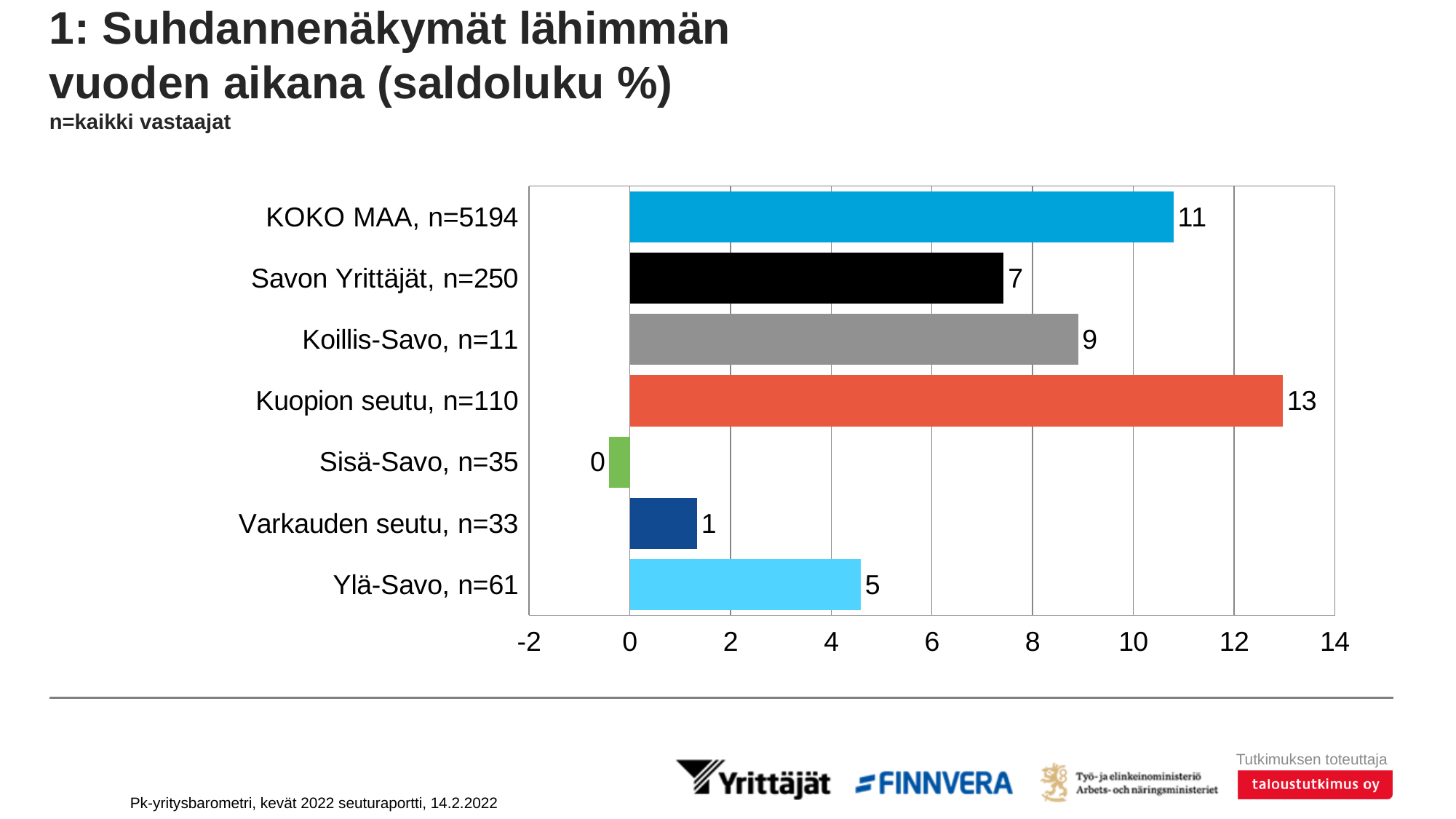
Which category has the highest value? Kuopion seutu, n=110 Which is larger, the value for Savon Yrittäjät, n=250 or the value for Koillis-Savo, n=11? Koillis-Savo, n=11 How many categories are shown in the chart? 7 What is the value for KOKO MAA, n=5194? 11 What is the maximum value shown on the horizontal axis? 14 Which category has the lowest value? Sisä-Savo, n=35 What is the value for Ylä-Savo, n=61? 5 What is the value for Savon Yrittäjät, n=250? 7 Is the value for Varkauden seutu, n=33 greater or less than 2? less What is the difference between the values for Kuopion seutu, n=110 and Koillis-Savo, n=11? 4 What kind of chart is shown on the slide? bar chart What is the value for Kuopion seutu, n=110? 13